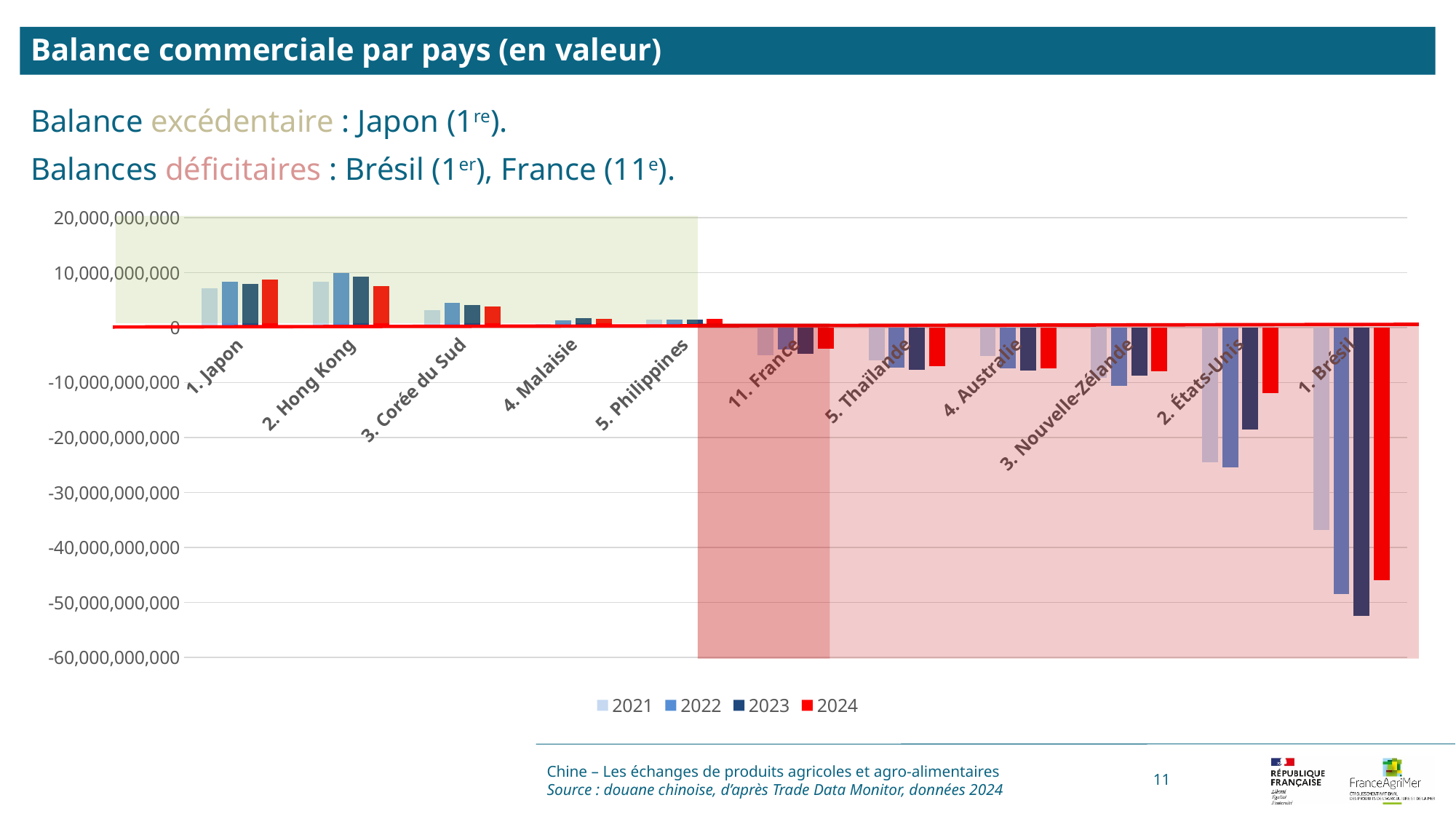
How many series does the legend list? 4 Which country and year has the lowest (most negative) value in the chart? 1. Brésil, 2023 Which is larger, the 2024 value for 2. États-Unis or the 2024 value for 1. Brésil? 2. États-Unis Is the 2024 value for 1. Brésil greater or less than -50,000,000,000? greater How many countries are shown on the x axis of the chart? 11 Is the 2024 value for 2. États-Unis greater or less than -10,000,000,000? less Which colour represents the 2024 series in the legend? red What kind of chart is shown on the slide? bar chart Which country has the highest 2024 value in the chart? 1. Japon Is the 2024 value for 1. Japon greater or less than 10,000,000,000? less